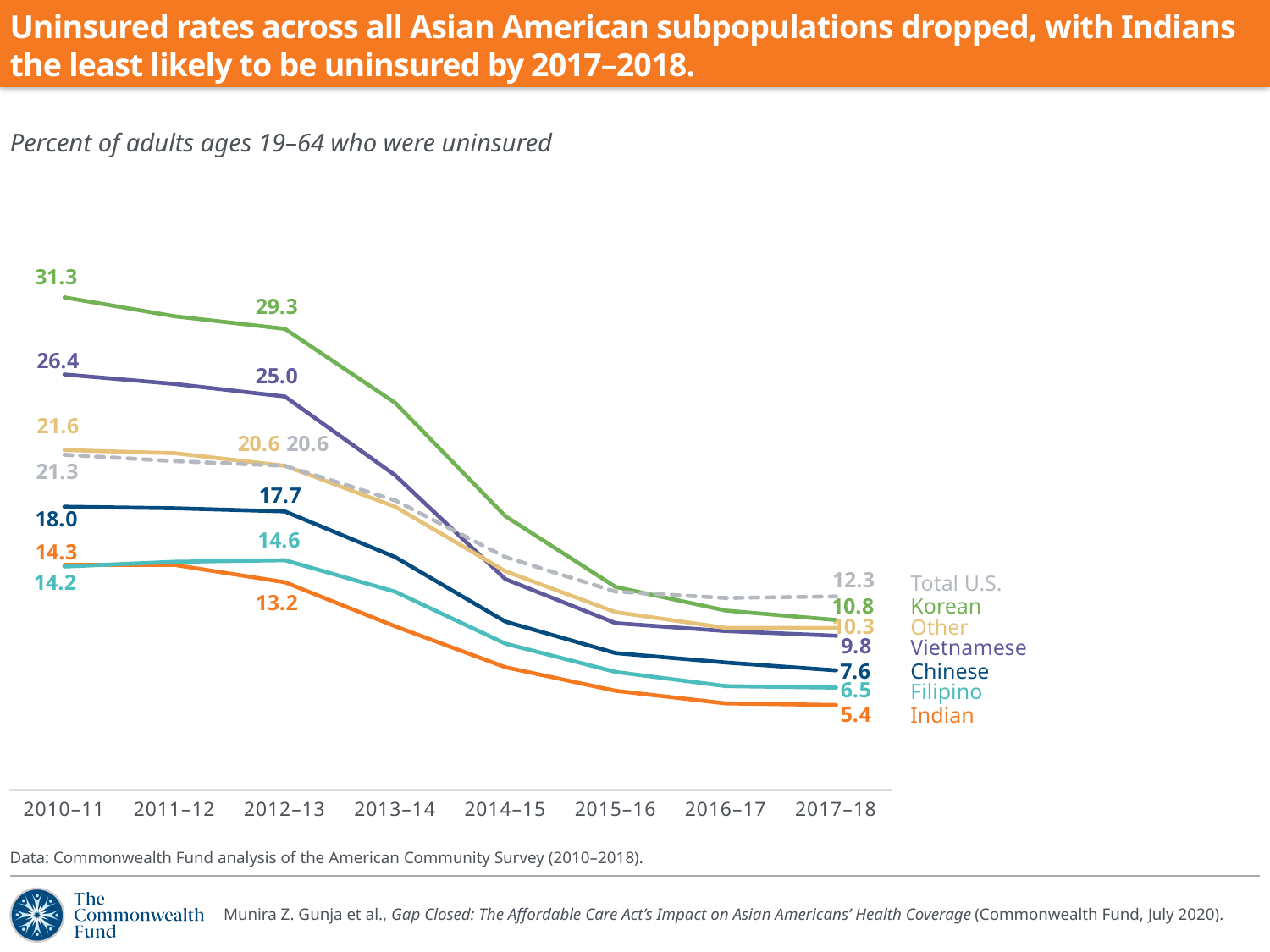
Does the uninsured rate for Vietnamese adults rise or fall from 2010–11 to 2017–18? Fall What was the Total U.S. uninsured rate in 2017–18? 12.3 Which group had the lowest uninsured rate in 2017–18? Indian What type of chart is shown on the slide? Line chart What was the uninsured rate for Korean adults in 2010–11? 31.3 Which group had the highest uninsured rate in 2010–11? Korean How many lines (series) are plotted on the chart? 7 How many time periods are shown on the x axis? 8 In 2012–13, which had the higher uninsured rate, Chinese or Filipino adults? Chinese What was the uninsured rate for Vietnamese adults in 2012–13? 25.0 By how many percentage points did the Korean uninsured rate fall from 2010–11 to 2017–18? 20.5 What was the uninsured rate for Indian adults in 2017–18? 5.4